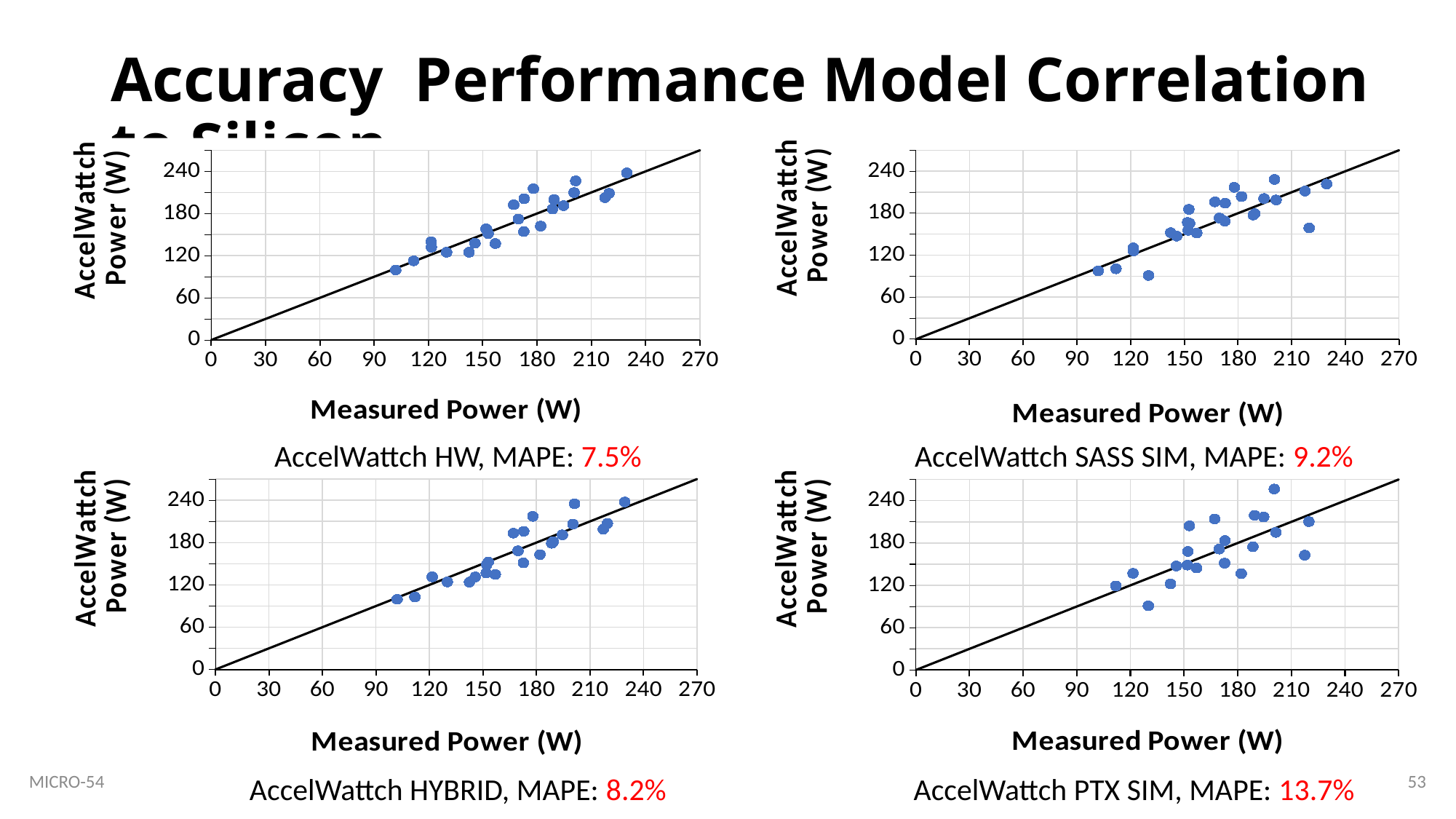
In the bottom-left chart (AccelWattch HYBRID), do the AccelWattch Power values generally rise or fall as Measured Power increases? rise What kind of chart is the top-left chart (AccelWattch HW)? scatter chart How many charts are shown on the slide? 4 In the top-right chart (AccelWattch SASS SIM), is the AccelWattch Power value of the lowest point greater or less than 120? less What is the difference between the MAPE of AccelWattch PTX SIM and the MAPE of AccelWattch HW? 6.2% Which of the four charts reports the highest MAPE? AccelWattch PTX SIM What MAPE value is reported for the AccelWattch PTX SIM chart? 13.7% Which of the four charts reports the lowest MAPE? AccelWattch HW What is the x-axis title of the bottom-right chart (AccelWattch PTX SIM)? Measured Power (W) In the bottom-right chart (AccelWattch PTX SIM), is the AccelWattch Power value of the highest point greater or less than 240? greater What MAPE value is reported for the AccelWattch HW chart? 7.5% Which is larger, the MAPE for AccelWattch SASS SIM or the MAPE for AccelWattch HYBRID? AccelWattch SASS SIM